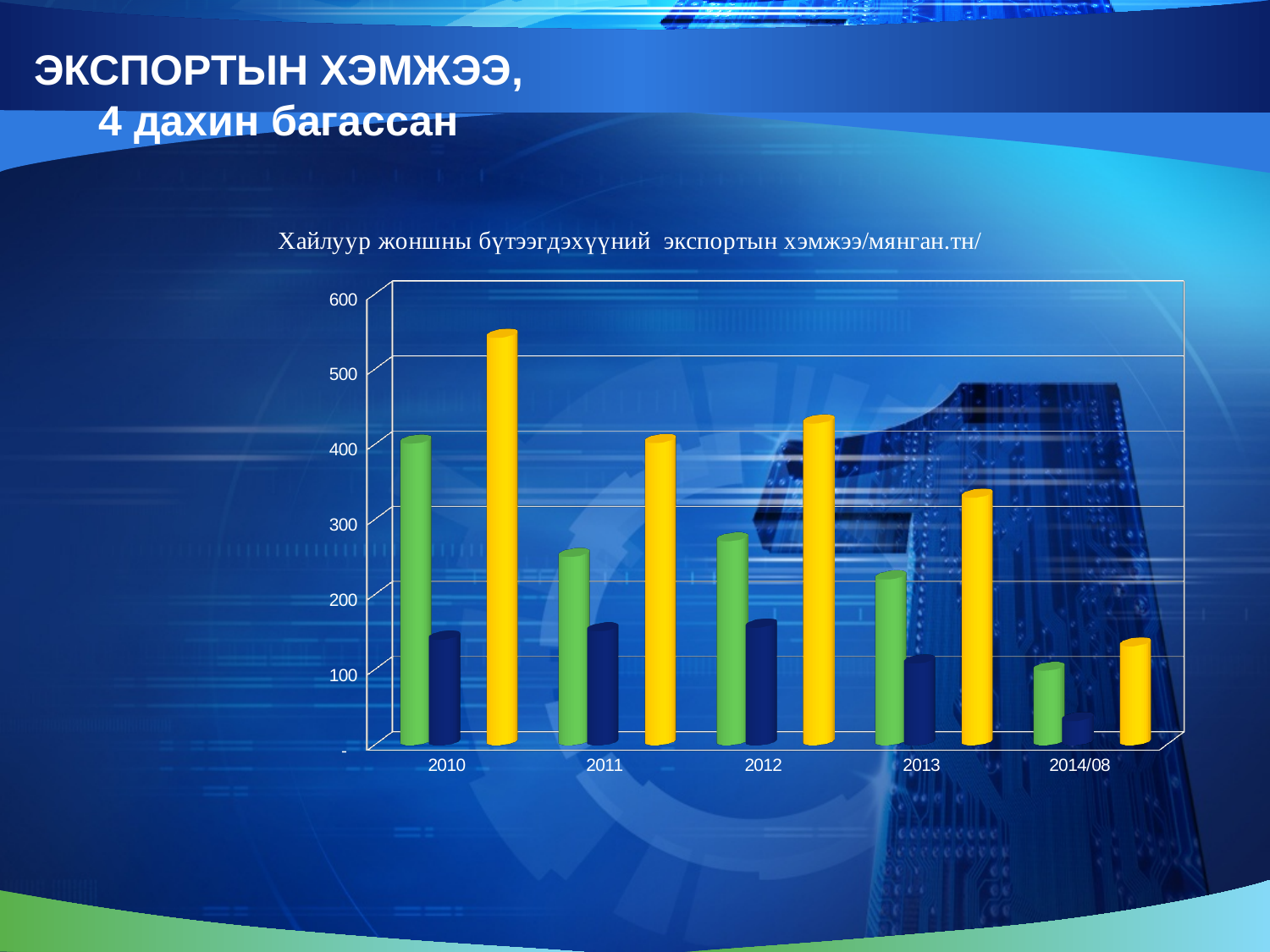
Do the yellow bars generally rise or fall from 2010 to 2014/08? fall In which year is the yellow bar the highest? 2010 How many bars are plotted for each year in the chart? 3 In which year is the green bar the highest? 2010 What is the title of the chart? Хайлуур жоншны бүтээгдэхүүний экспортын хэмжээ/мянган.тн/ Is the value of the green bar for 2014/08 greater or less than 200? less How many categories (years) are shown on the x axis of the chart? 5 Is the value of the yellow bar for 2010 greater or less than 500? greater In 2010, which bar is larger, the yellow bar or the green bar? the yellow bar What kind of chart is shown on the slide? bar chart In which year is the green bar the lowest? 2014/08 In which year is the yellow bar the lowest? 2014/08